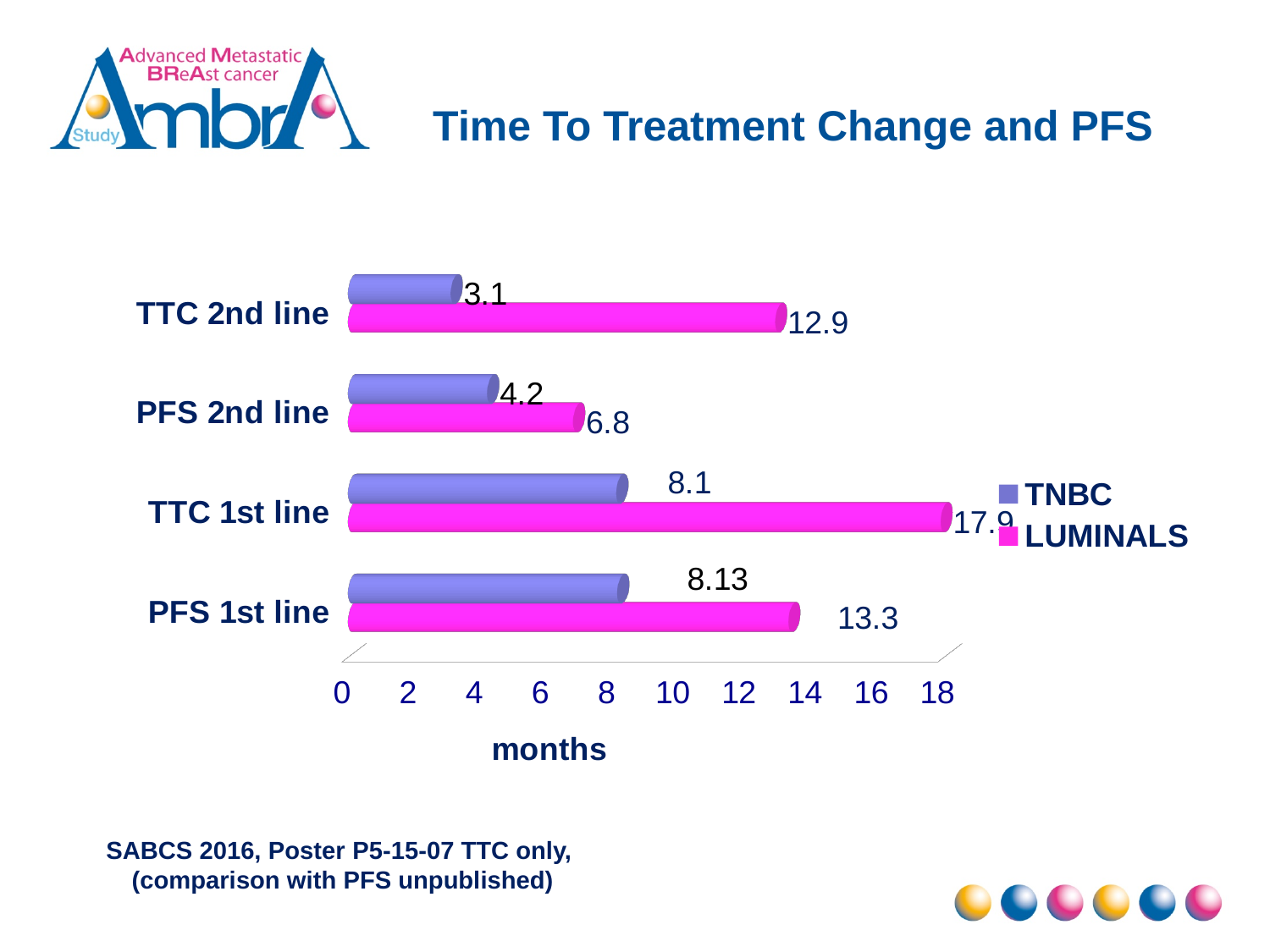
Which category has the lowest TNBC value? TTC 2nd line What is the LUMINALS value for PFS 2nd line? 6.8 What is the LUMINALS value for TTC 1st line? 17.9 Which category has the highest LUMINALS value? TTC 1st line How many categories are shown on the chart? 4 What is the difference between the LUMINALS and TNBC values for TTC 2nd line? 9.8 Which is larger for PFS 2nd line, the TNBC value or the LUMINALS value? LUMINALS What is the TNBC value for PFS 1st line? 8.13 What is the TNBC value for TTC 2nd line? 3.1 What kind of chart is shown on the slide? Bar chart How many series does the legend list? 2 What is the label of the horizontal axis? months